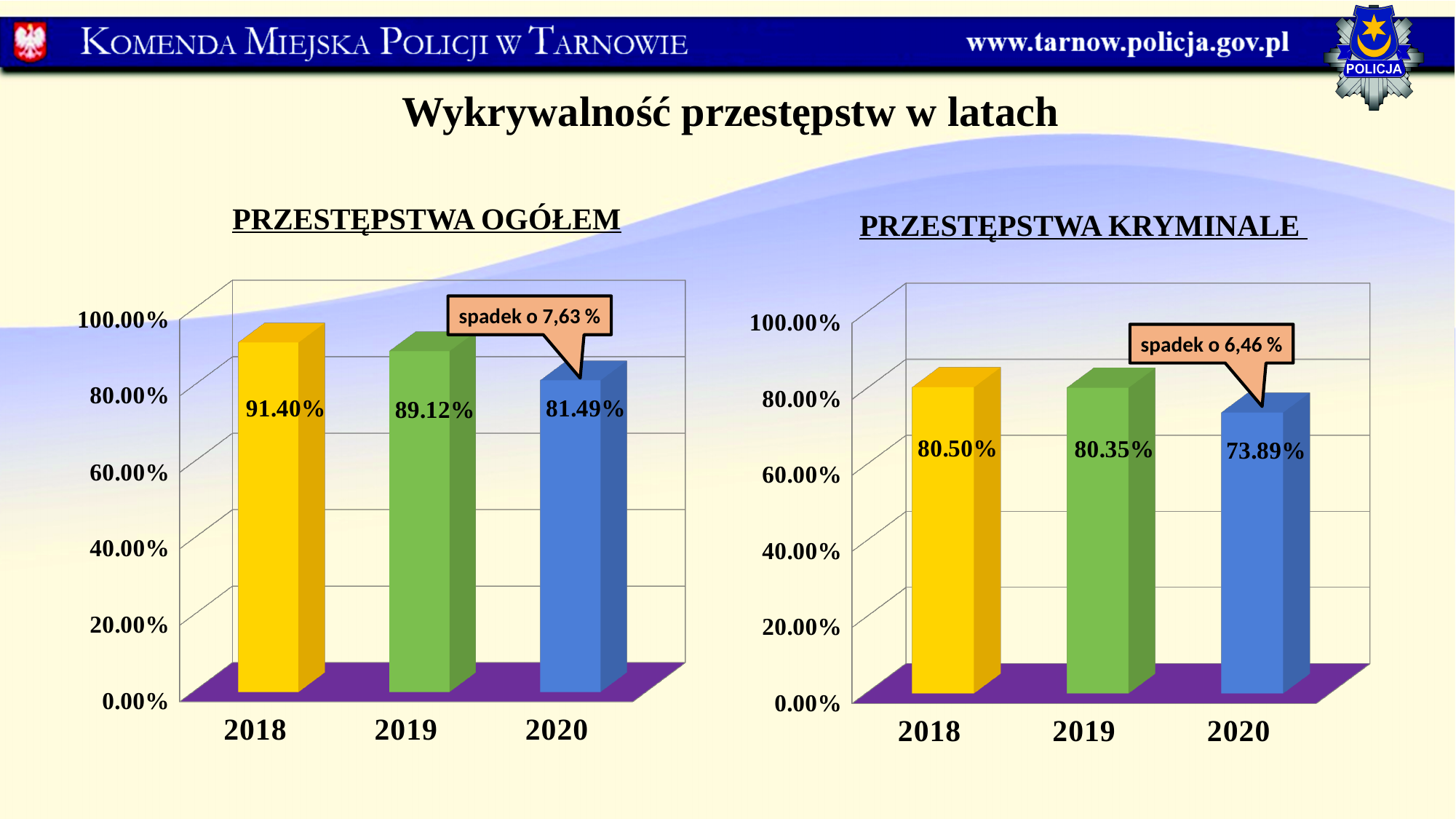
In the PRZESTĘPSTWA KRYMINALE chart, which year has the lowest value? 2020 In the PRZESTĘPSTWA OGÓŁEM chart, what is the value for 2018? 91.40% In the PRZESTĘPSTWA KRYMINALE chart, what is the value for 2020? 73.89% In the PRZESTĘPSTWA OGÓŁEM chart, which is larger, the value for 2019 or the value for 2020? 2019 How many years are shown in the PRZESTĘPSTWA OGÓŁEM chart? 3 In the PRZESTĘPSTWA KRYMINALE chart, what is the value for 2019? 80.35% In the PRZESTĘPSTWA OGÓŁEM chart, what is the value for 2020? 81.49% In the PRZESTĘPSTWA OGÓŁEM chart, what is the difference between the 2019 and 2020 values? 7.63 percentage points In the PRZESTĘPSTWA KRYMINALE chart, is the value for 2020 greater or less than 80.00%? less In the PRZESTĘPSTWA OGÓŁEM chart, which year has the highest value? 2018 What kind of chart is the PRZESTĘPSTWA KRYMINALE chart? bar chart In the PRZESTĘPSTWA KRYMINALE chart, what is the difference between the 2018 and 2020 values? 6.61 percentage points